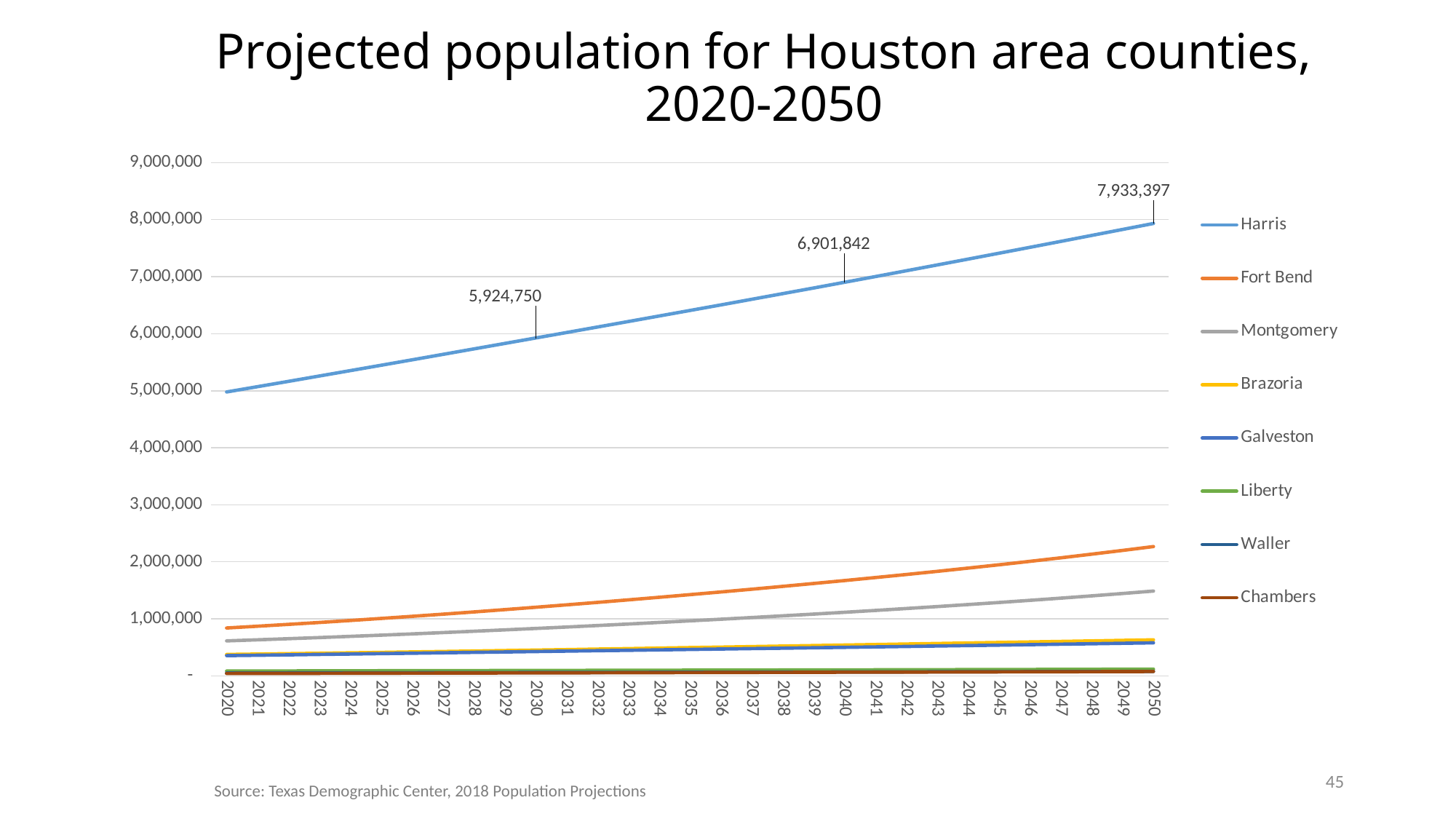
By how much does the Harris County projection increase between 2030 and 2050? 2,008,647 What is the difference between the Harris County projections for 2040 and 2050? 1,031,555 How many series does the legend list? 8 Does the projected population of Harris County rise or fall from 2020 to 2050? Rises Is the projected population of Montgomery County in 2050 greater or less than 2,000,000? less In 2050, which county has the larger projected population, Fort Bend or Montgomery? Fort Bend Is the projected population of Fort Bend County in 2050 greater or less than 2,000,000? greater What is the projected population of Harris County in 2030? 5,924,750 Which county has the highest projected population in 2050? Harris What is the projected population of Harris County in 2050? 7,933,397 What kind of chart is shown on the slide? Line chart What is the projected population of Harris County in 2040? 6,901,842